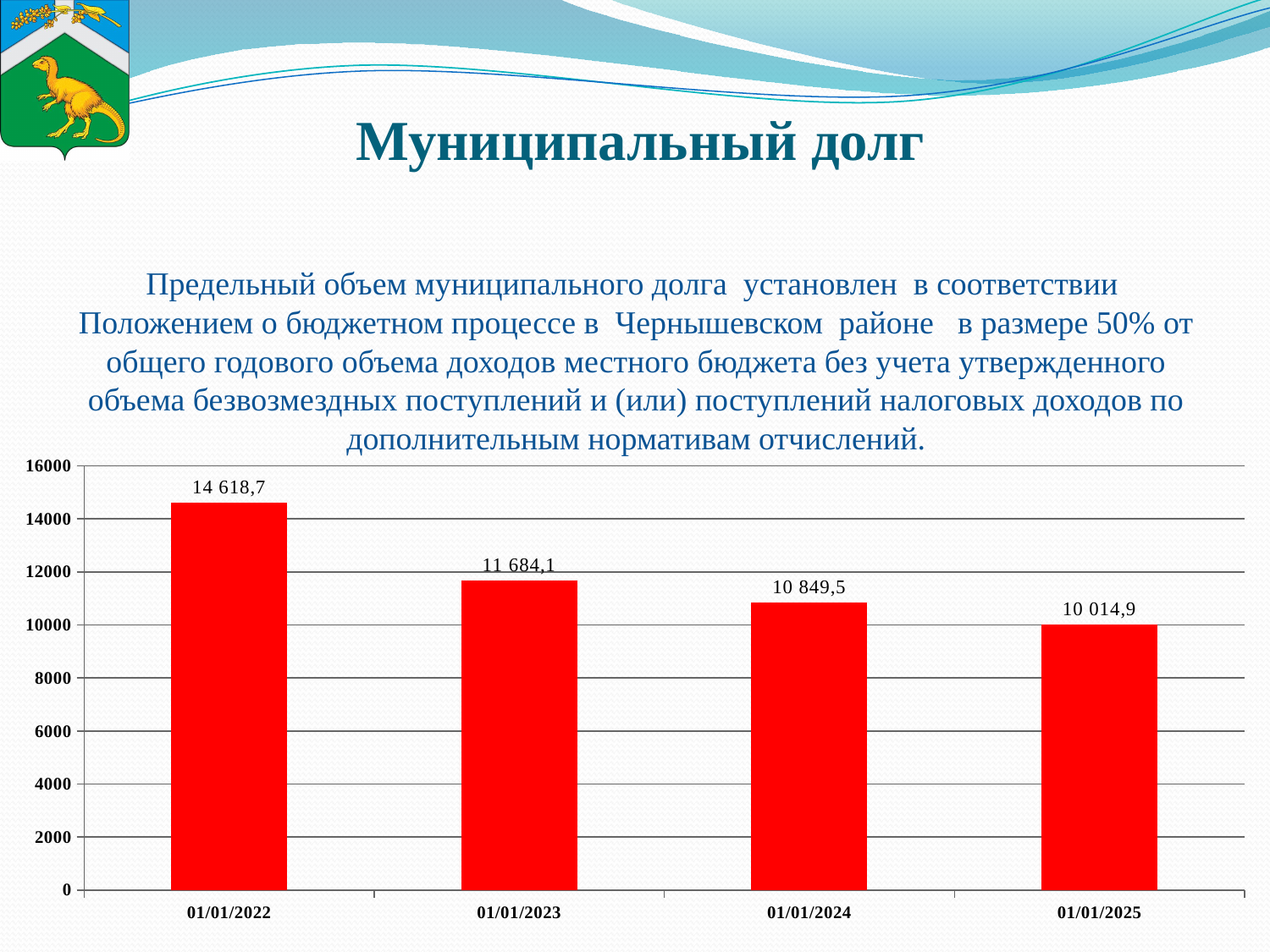
What is the value for 01/01/2023? 11 684,1 What is the difference between the values for 01/01/2022 and 01/01/2023? 2 934,6 Which is larger, the value for 01/01/2023 or the value for 01/01/2024? 01/01/2023 What is the value for 01/01/2022? 14 618,7 Which date has the lowest value? 01/01/2025 How many bars are shown in the chart? 4 Which date has the highest value? 01/01/2022 Do the values rise or fall from 01/01/2022 to 01/01/2025? fall What is the difference between the values for 01/01/2022 and 01/01/2025? 4 603,8 What is the value for 01/01/2024? 10 849,5 Is the value for 01/01/2024 greater or less than 12000? less What is the value for 01/01/2025? 10 014,9